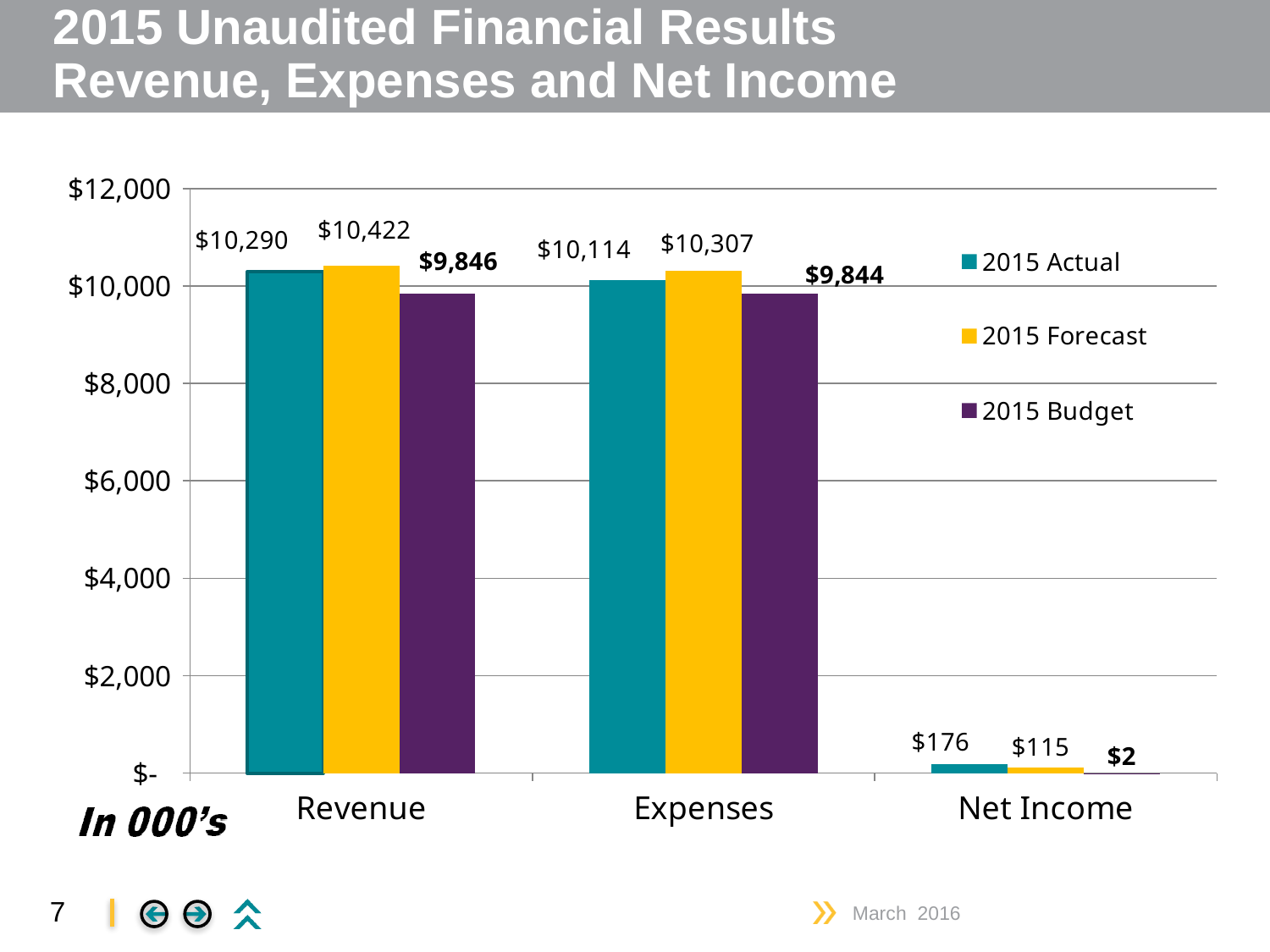
What kind of chart is shown on the slide? bar chart Which category has the lowest 2015 Forecast value? Net Income What is the difference between the 2015 Forecast and 2015 Actual values for Revenue? $132 Is the 2015 Budget value for Revenue greater or less than $10,000? less What is the 2015 Budget value for Net Income? $2 What is the difference between the 2015 Actual and 2015 Forecast values for Net Income? $61 What is the 2015 Actual value for Net Income? $176 How many series does the legend list? 3 What is the 2015 Actual value for Revenue? $10,290 Is the 2015 Actual value for Expenses larger or smaller than the 2015 Budget value for Expenses? larger What is the 2015 Forecast value for Expenses? $10,307 Which series has the highest value for Revenue? 2015 Forecast